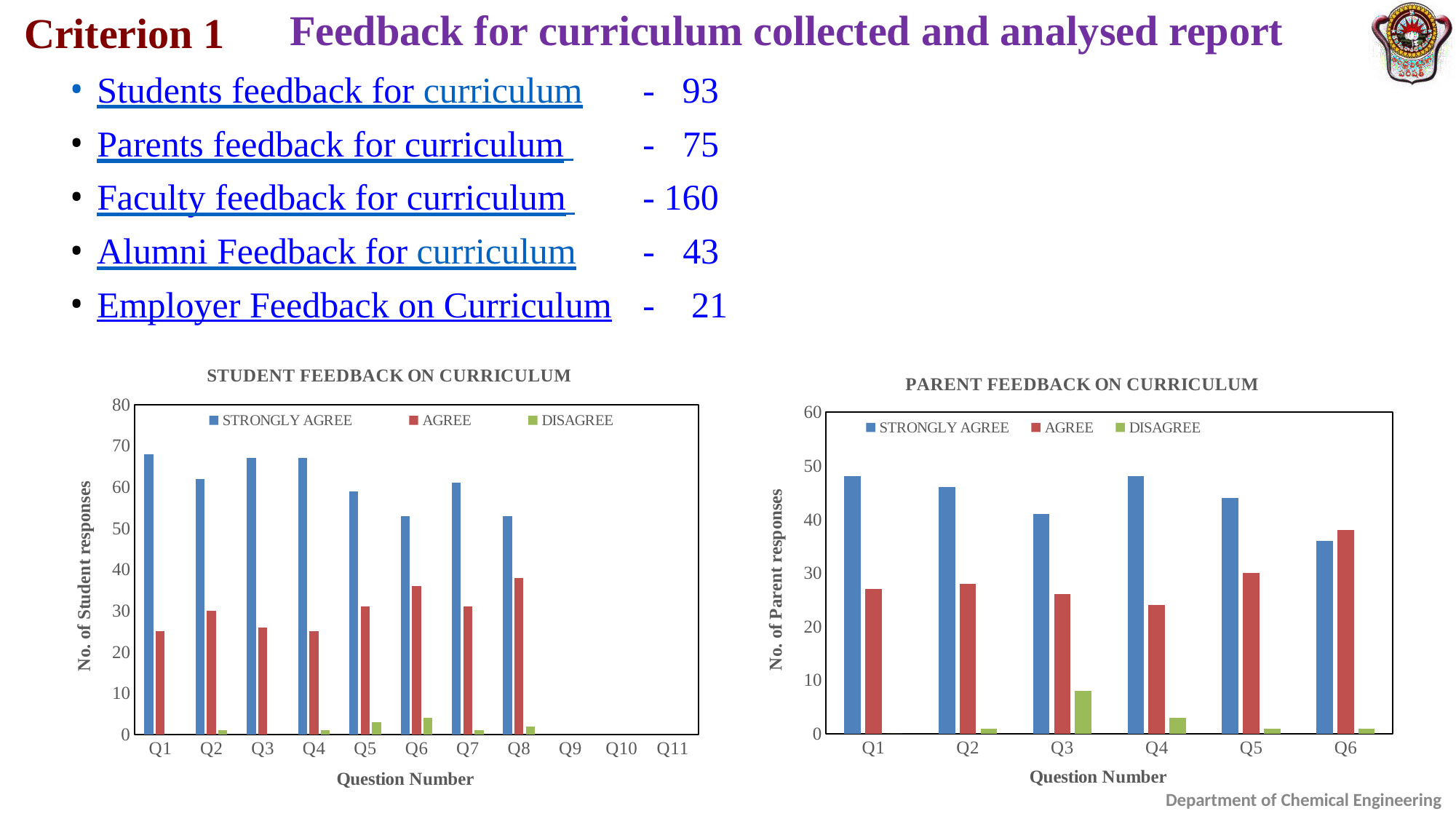
In the PARENT FEEDBACK ON CURRICULUM chart, which question has the highest AGREE value? Q6 In the PARENT FEEDBACK ON CURRICULUM chart, which question has the highest DISAGREE value? Q3 In the PARENT FEEDBACK ON CURRICULUM chart, which is larger for Q1: STRONGLY AGREE or AGREE? STRONGLY AGREE What is the y-axis title of the PARENT FEEDBACK ON CURRICULUM chart? No. of Parent responses In the PARENT FEEDBACK ON CURRICULUM chart, which question has the lowest STRONGLY AGREE value? Q6 What kind of chart is the STUDENT FEEDBACK ON CURRICULUM chart? bar chart How many question labels are shown on the x axis of the STUDENT FEEDBACK ON CURRICULUM chart? 11 In the STUDENT FEEDBACK ON CURRICULUM chart, is the STRONGLY AGREE value for Q1 greater or less than 60? greater How many question categories are shown on the x axis of the PARENT FEEDBACK ON CURRICULUM chart? 6 In the STUDENT FEEDBACK ON CURRICULUM chart, is the STRONGLY AGREE value for Q6 greater or less than 60? less In the STUDENT FEEDBACK ON CURRICULUM chart, is the AGREE value for Q8 greater or less than 30? greater How many series does the legend of the PARENT FEEDBACK ON CURRICULUM chart list? 3